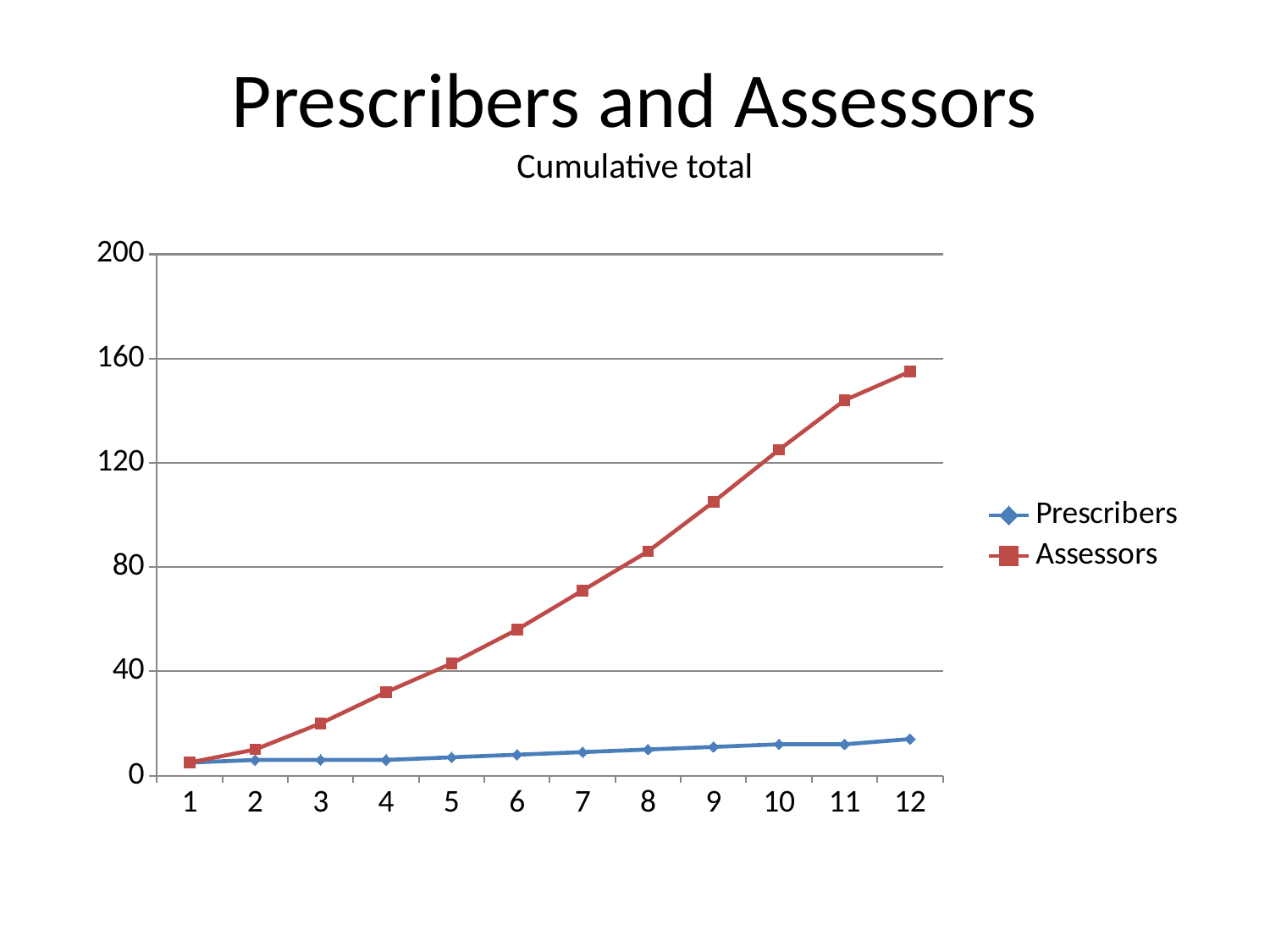
At which point does the Assessors series reach its highest value? 12 What kind of chart is shown on the slide? line chart Which series has the higher value at point 12, Prescribers or Assessors? Assessors How many series does the legend list? 2 Is the value for Assessors at point 9 greater or less than 80? greater Is the value for Assessors at point 12 greater or less than 160? less Is the value for Assessors at point 4 greater or less than 40? less What is the subtitle shown under the chart title? Cumulative total How many points are plotted along the x axis for each series? 12 Do the values for Assessors rise or fall from point 1 to point 12? rise